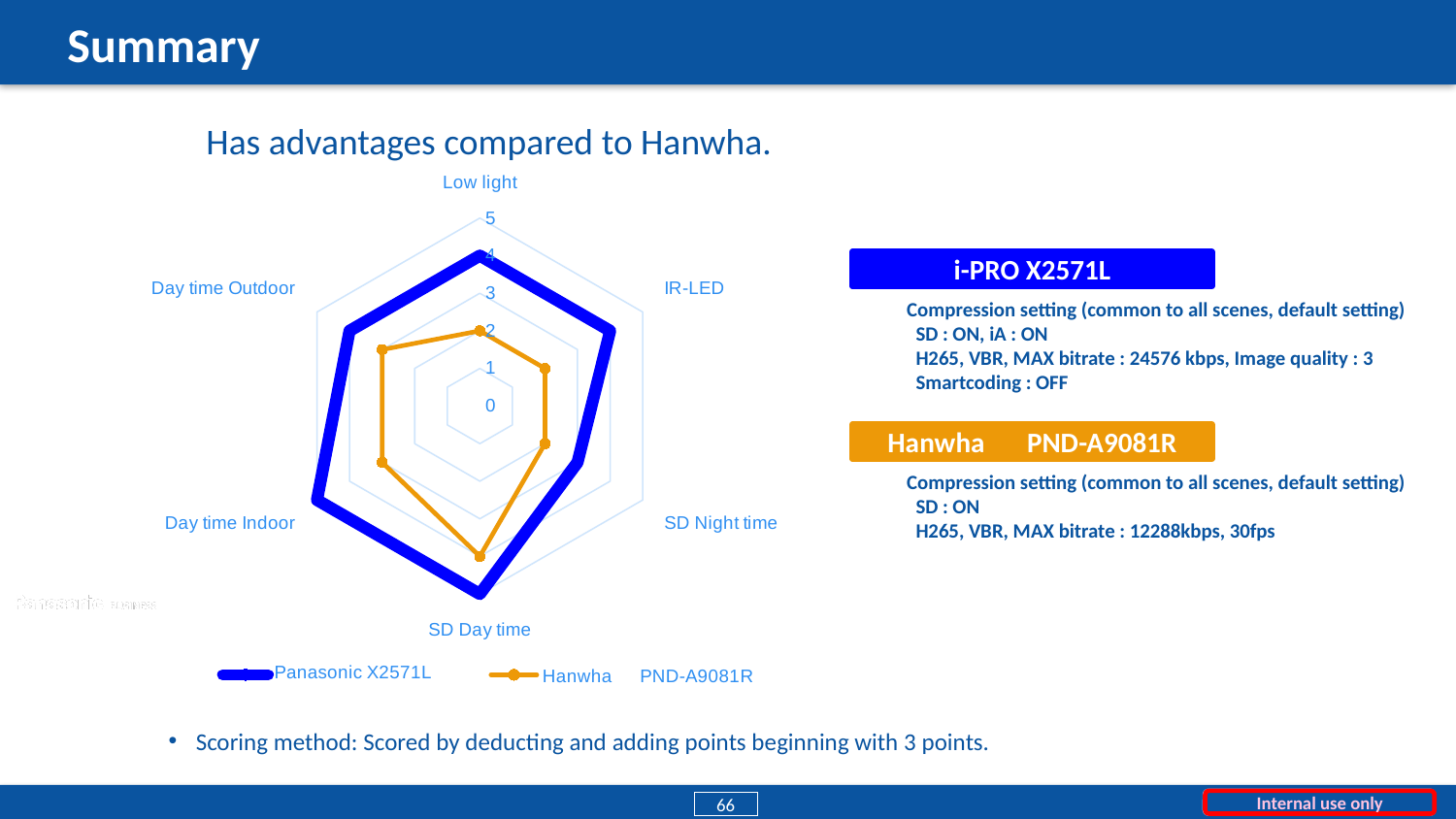
In which category does Hanwha PND-A9081R score highest? SD Day time What are the two series named in the chart legend? Panasonic X2571L and Hanwha PND-A9081R How many categories (axes) does the radar chart have? 6 Which series has the higher Low light score, Panasonic X2571L or Hanwha PND-A9081R? Panasonic X2571L What is the difference between the Low light scores of Panasonic X2571L and Hanwha PND-A9081R? 2 What is the maximum value shown on the radar chart's axis scale? 5 What is the Low light score for Hanwha PND-A9081R? 2 Is the SD Day time value for Panasonic X2571L greater or less than 3? greater What kind of chart is shown on the slide? Radar chart What is the Low light score for Panasonic X2571L? 4 Is the IR-LED value for Hanwha PND-A9081R greater or less than 3? less How many series does the chart legend list? 2